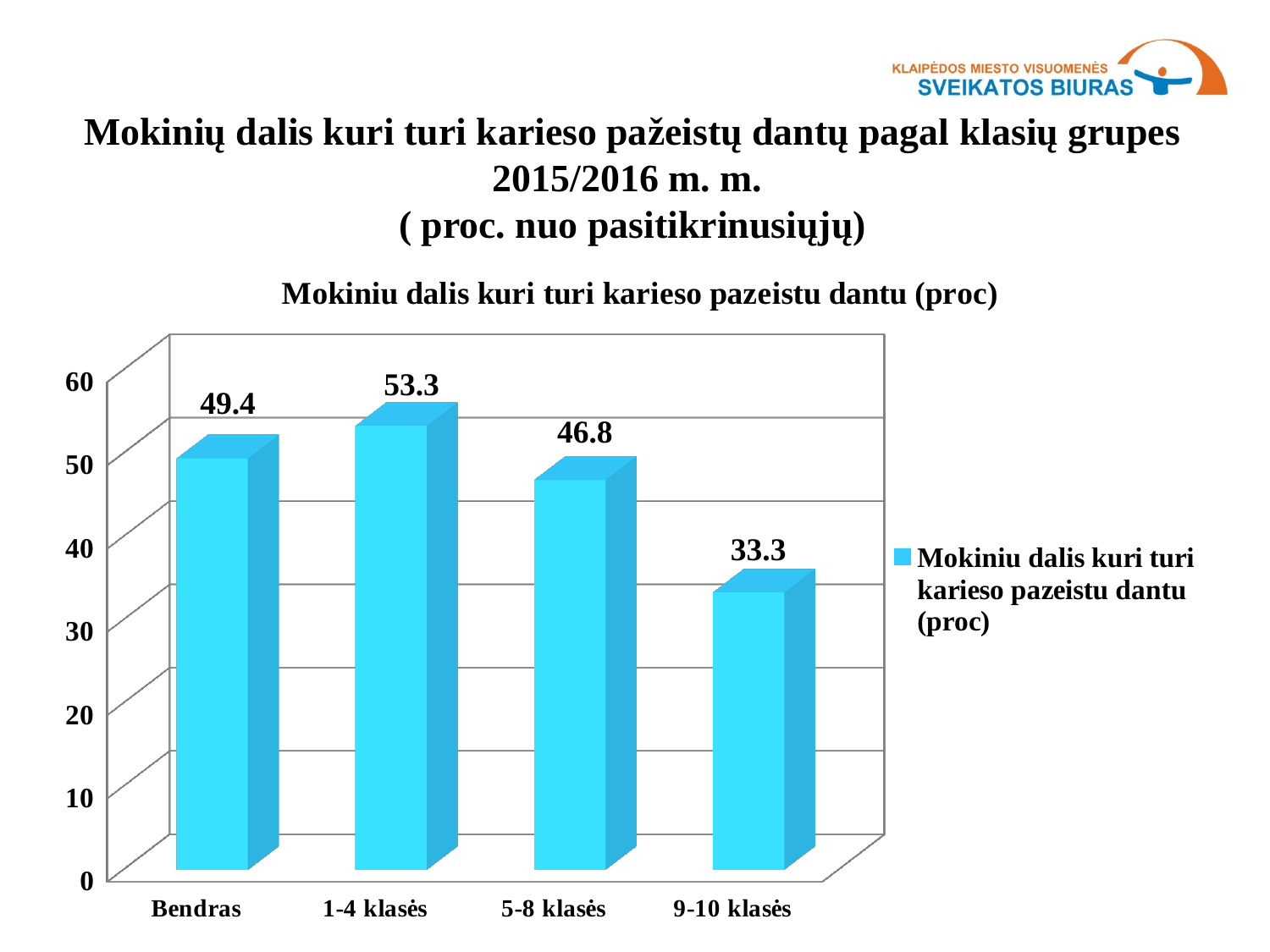
What is the value for 5-8 klasės? 46.8 What is the value for Bendras? 49.4 What is the difference between the values for 1-4 klasės and 9-10 klasės? 20 How many categories are shown on the x axis? 4 Which category has the highest value? 1-4 klasės Which category has the lowest value? 9-10 klasės Is the value for 9-10 klasės greater or less than 40? less What is the value for 1-4 klasės? 53.3 Which is larger, the value for Bendras or the value for 5-8 klasės? Bendras What is the value for 9-10 klasės? 33.3 What is the title of the chart? Mokiniu dalis kuri turi karieso pazeistu dantu (proc) What kind of chart is shown on the slide? bar chart